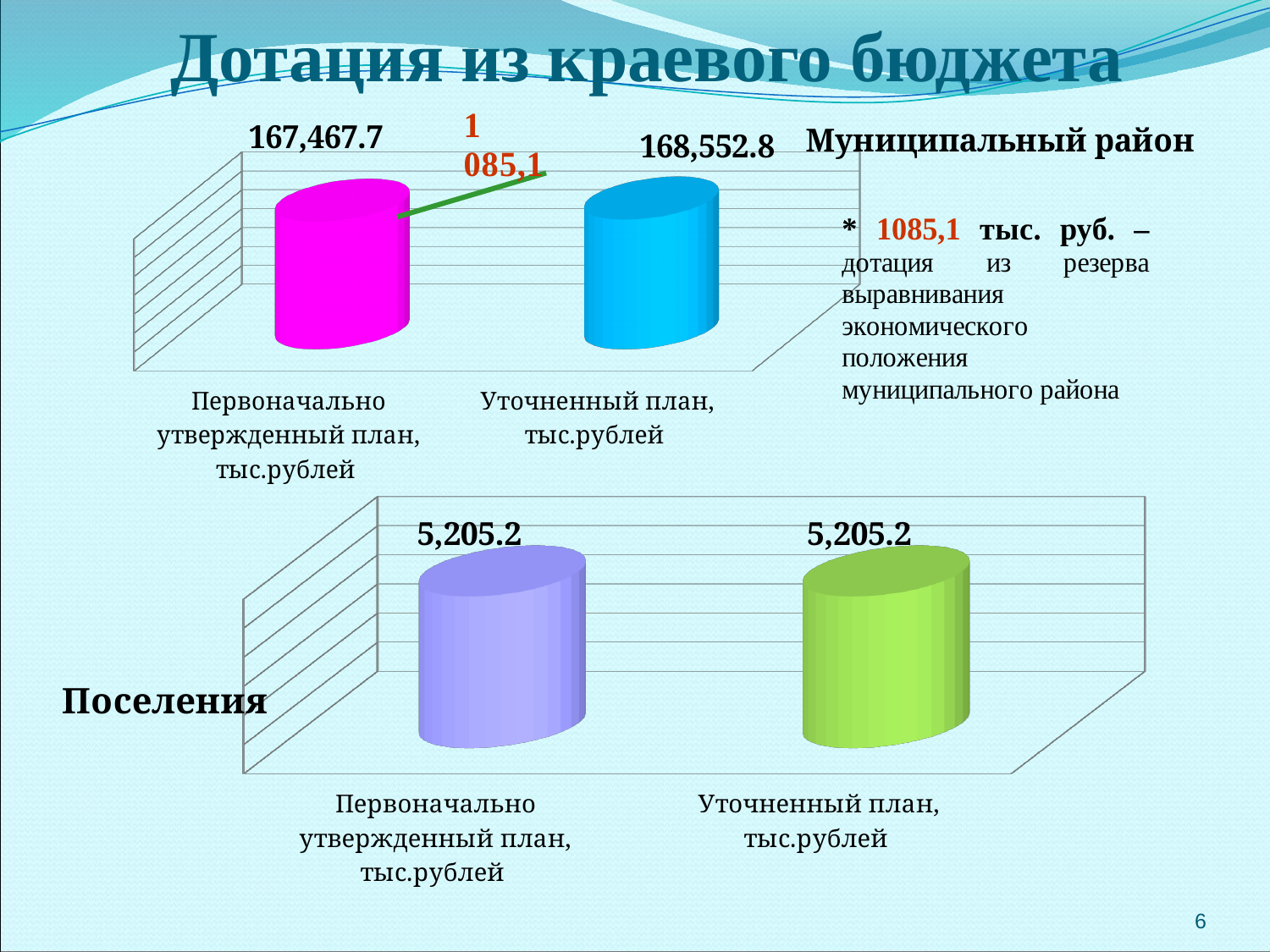
What kind of chart is the top chart (Муниципальный район)? bar chart In the top chart (Муниципальный район), is the value for Уточненный план larger or smaller than the value for Первоначально утвержденный план? larger In the bottom chart (Поселения), what is the value for Уточненный план, тыс.рублей? 5,205.2 In the top chart (Муниципальный район), what is the difference between Уточненный план and Первоначально утвержденный план? 1,085.1 In the bottom chart (Поселения), what is the value for Первоначально утвержденный план, тыс.рублей? 5,205.2 In the bottom chart (Поселения), what is the difference between the two plotted values? 0 In the top chart (Муниципальный район), what is the value for Первоначально утвержденный план, тыс.рублей? 167,467.7 In the top chart (Муниципальный район), which category has the higher value? Уточненный план, тыс.рублей How many categories are plotted in the bottom chart (Поселения)? 2 In the top chart (Муниципальный район), what is the value for Уточненный план, тыс.рублей? 168,552.8 What colour is the bar for Уточненный план in the bottom chart (Поселения)? green In the top chart (Муниципальный район), which category has the lower value? Первоначально утвержденный план, тыс.рублей